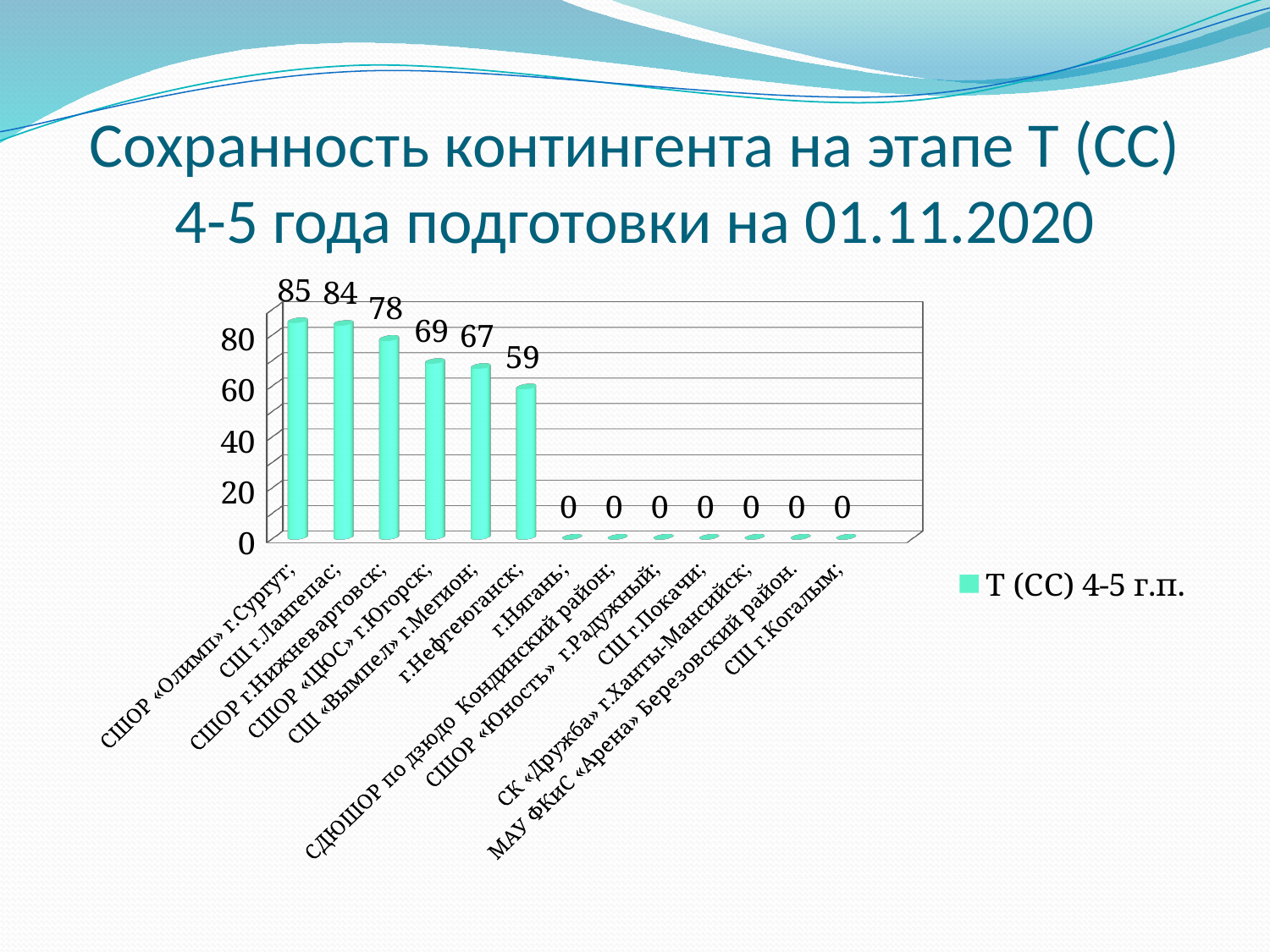
What is the value for СШ г.Лангепас? 84 What series name is listed in the legend? Т (СС) 4-5 г.п. What is the value for СШОР «Олимп» г.Сургут? 85 What is the difference between the values for СШОР «ЦЮС» г.Югорск and СШ «Вымпел» г.Мегион? 2 How many categories have a value of 0? 7 What is the value for СШ г.Когалым? 0 Which is larger, the value for СШОР г.Нижневартовск or the value for г.Нефтеюганск? СШОР г.Нижневартовск What is the value for г.Нефтеюганск? 59 What is the value for СШОР г.Нижневартовск? 78 Which category has the highest value? СШОР «Олимп» г.Сургут What type of chart is shown on the slide? bar chart How many categories are shown on the x axis? 13